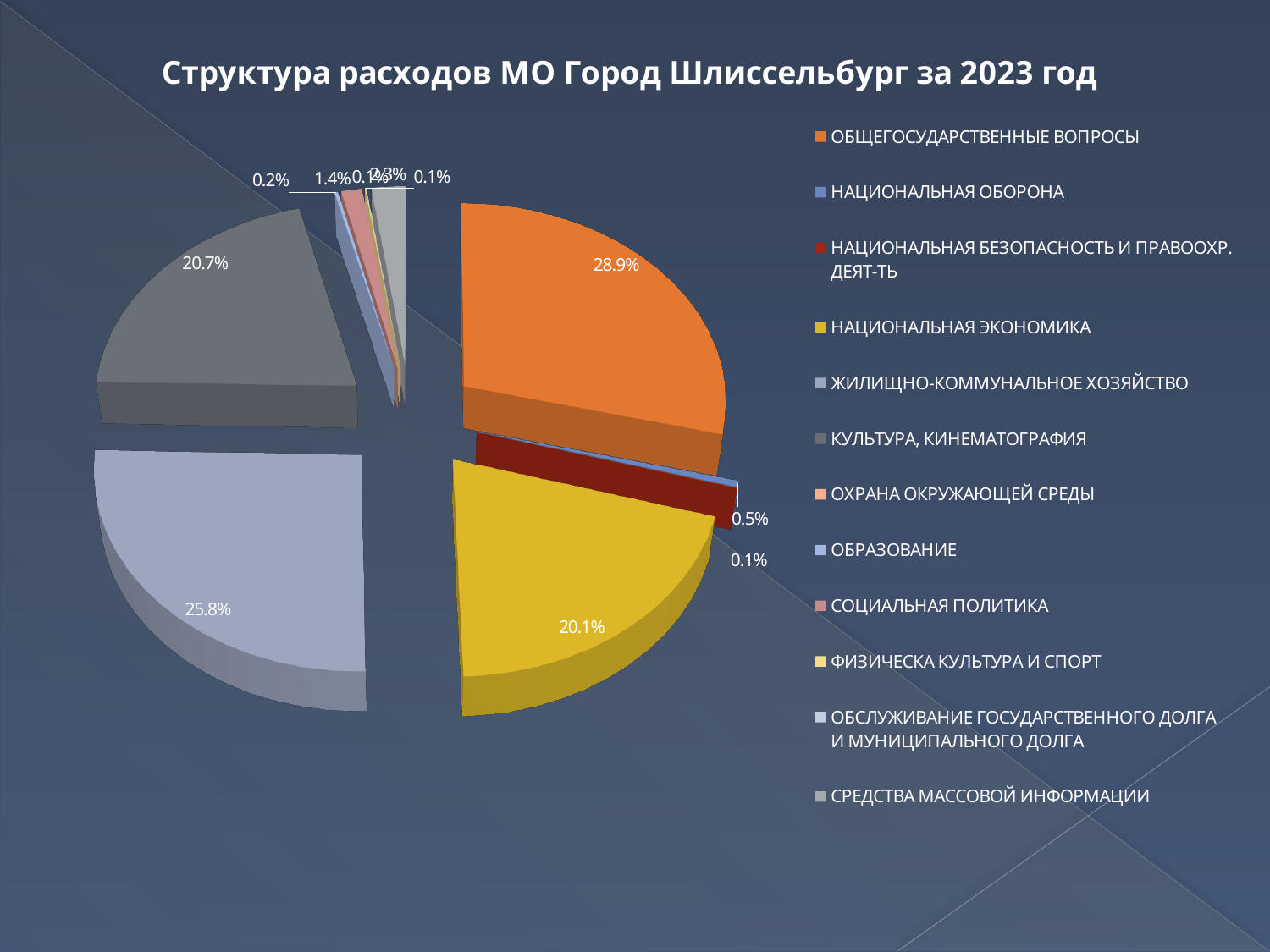
What share of the pie is ОБЩЕГОСУДАРСТВЕННЫЕ ВОПРОСЫ? 28.9% What kind of chart is shown on the slide? Pie chart What is the title of the chart? Структура расходов МО Город Шлиссельбург за 2023 год How many categories does the legend list? 12 What is the difference in percentage points between ОБЩЕГОСУДАРСТВЕННЫЕ ВОПРОСЫ and ЖИЛИЩНО-КОММУНАЛЬНОЕ ХОЗЯЙСТВО? 3.1 What is the value shown for КУЛЬТУРА, КИНЕМАТОГРАФИЯ? 20.7% What is the value shown for НАЦИОНАЛЬНАЯ БЕЗОПАСНОСТЬ И ПРАВООХР. ДЕЯТ-ТЬ? 0.1% What is the value shown for ЖИЛИЩНО-КОММУНАЛЬНОЕ ХОЗЯЙСТВО? 25.8% What is the difference in percentage points between КУЛЬТУРА, КИНЕМАТОГРАФИЯ and НАЦИОНАЛЬНАЯ ЭКОНОМИКА? 0.6 Which category has the largest share of the pie? ОБЩЕГОСУДАРСТВЕННЫЕ ВОПРОСЫ What is the value shown for НАЦИОНАЛЬНАЯ ЭКОНОМИКА? 20.1% Which is larger, the share for ЖИЛИЩНО-КОММУНАЛЬНОЕ ХОЗЯЙСТВО or for КУЛЬТУРА, КИНЕМАТОГРАФИЯ? ЖИЛИЩНО-КОММУНАЛЬНОЕ ХОЗЯЙСТВО